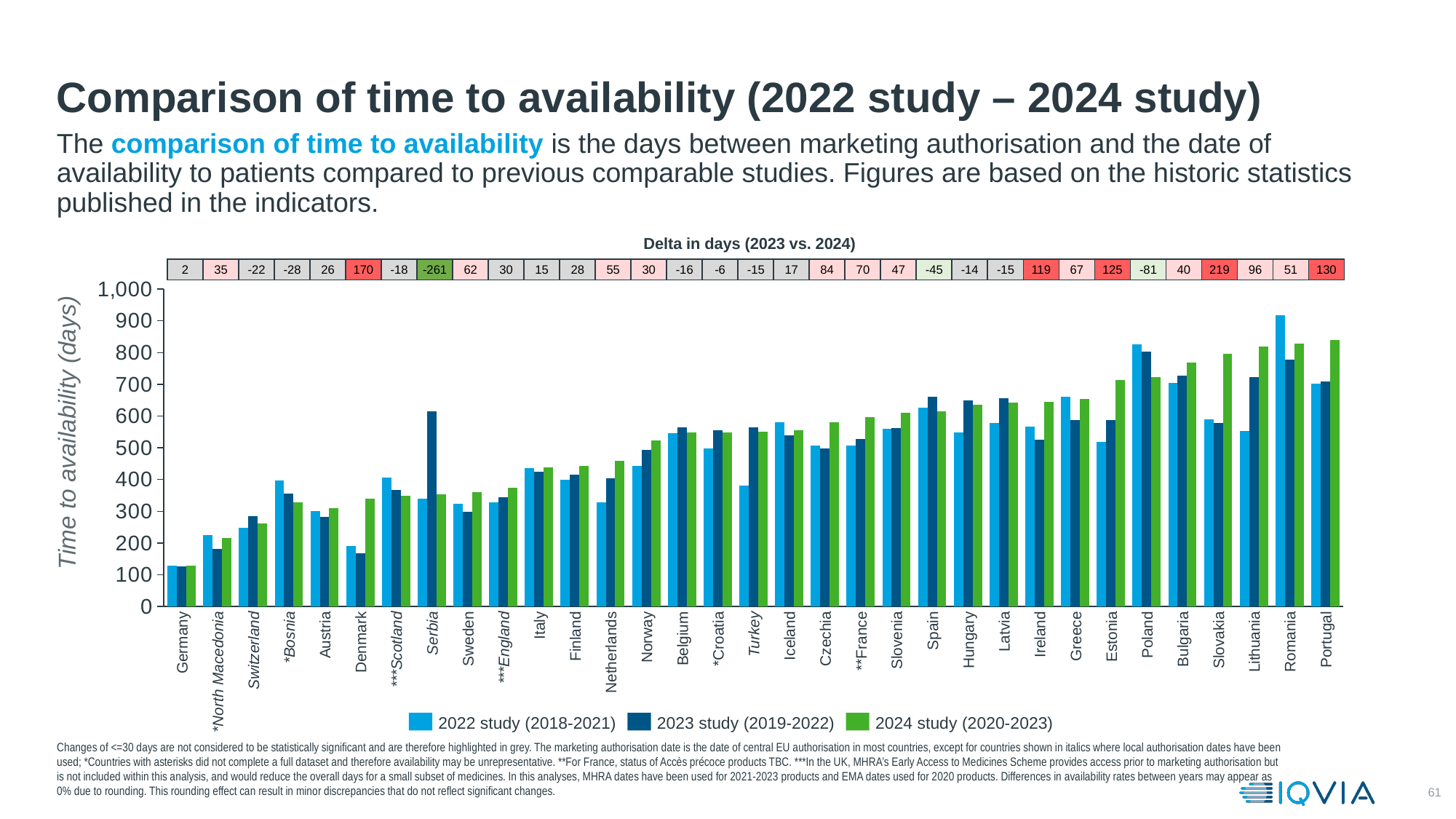
Is the 2022 study (2018-2021) value for Romania greater or less than 800 days? greater How many series does the legend list? 3 Which country has the highest delta in days (2023 vs. 2024)? Slovakia What kind of chart is shown on the slide? bar chart What is the delta in days (2023 vs. 2024) shown for Slovakia? 219 Which country has the larger 2024 study (2020-2023) value, Germany or Portugal? Portugal What is the delta in days (2023 vs. 2024) shown for Denmark? 170 Which country has the lowest delta in days (2023 vs. 2024)? Serbia What is the delta in days (2023 vs. 2024) shown for Serbia? -261 How many countries are shown on the x axis of the chart? 33 What is the difference between the delta in days for Slovakia and the delta in days for Denmark? 49 Do the time to availability values generally rise or fall moving from left to right along the x axis? rise